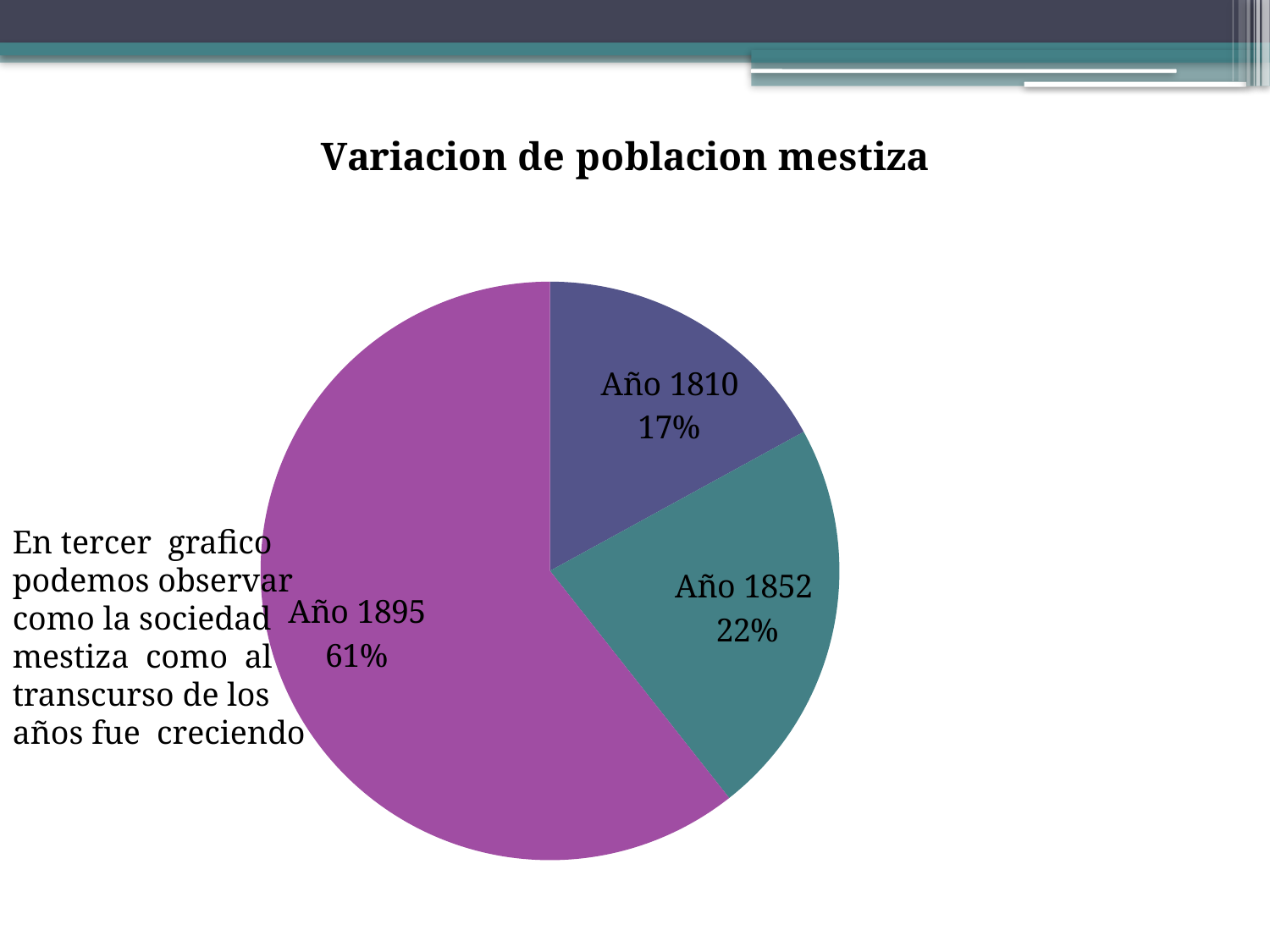
What is the difference in percentage points between Año 1895 and Año 1852? 39 Which slice is the largest? Año 1895 What share of the pie does Año 1852 represent? 22% Which is larger, the share for Año 1852 or the share for Año 1810? Año 1852 What colour is the Año 1895 slice? purple What share of the pie does Año 1895 represent? 61% How many slices does the pie chart have? 3 What share of the pie does Año 1810 represent? 17% What is the difference in percentage points between Año 1852 and Año 1810? 5 What is the title of the chart? Variacion de poblacion mestiza What kind of chart is shown on the slide? pie chart Which slice is the smallest? Año 1810